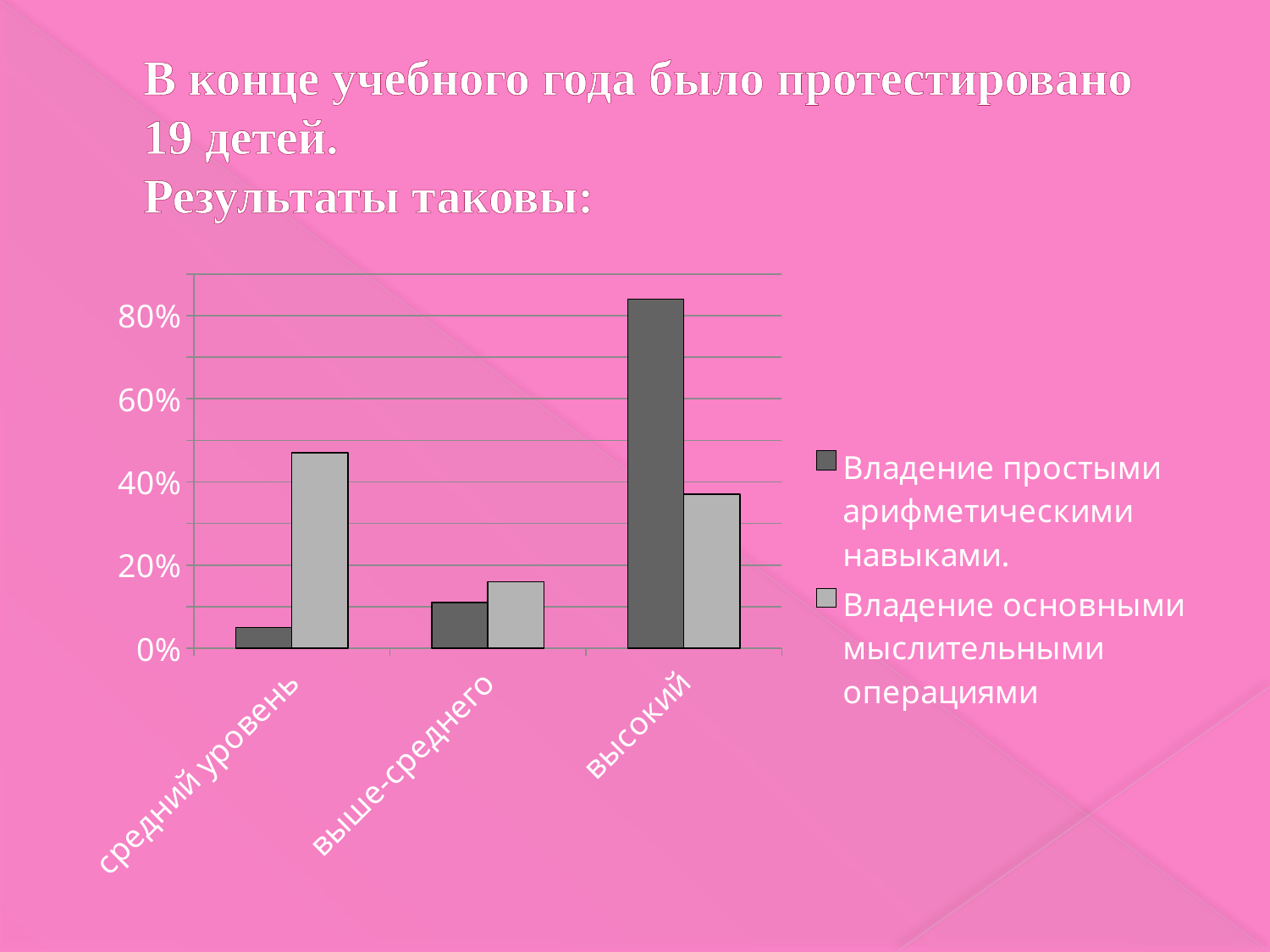
Which category has the lowest value for the series 'Владение основными мыслительными операциями'? выше-среднего Which category has the highest value for the series 'Владение основными мыслительными операциями'? средний уровень Which category has the highest value for the series 'Владение простыми арифметическими навыками.'? высокий Which category has the lowest value for the series 'Владение простыми арифметическими навыками.'? средний уровень Is the value for 'выше-среднего' in the series 'Владение основными мыслительными операциями' greater or less than 20%? less Is the value for 'высокий' in the series 'Владение простыми арифметическими навыками.' greater or less than 80%? greater Which series is shown with the lighter grey bars in the chart? Владение основными мыслительными операциями What kind of chart is shown on the slide? bar chart Is the value for 'средний уровень' in the series 'Владение основными мыслительными операциями' greater or less than 40%? greater How many series does the chart legend list? 2 How many categories are shown on the x axis of the chart? 3 For the category 'высокий', which series has the larger value: 'Владение простыми арифметическими навыками.' or 'Владение основными мыслительными операциями'? Владение простыми арифметическими навыками.